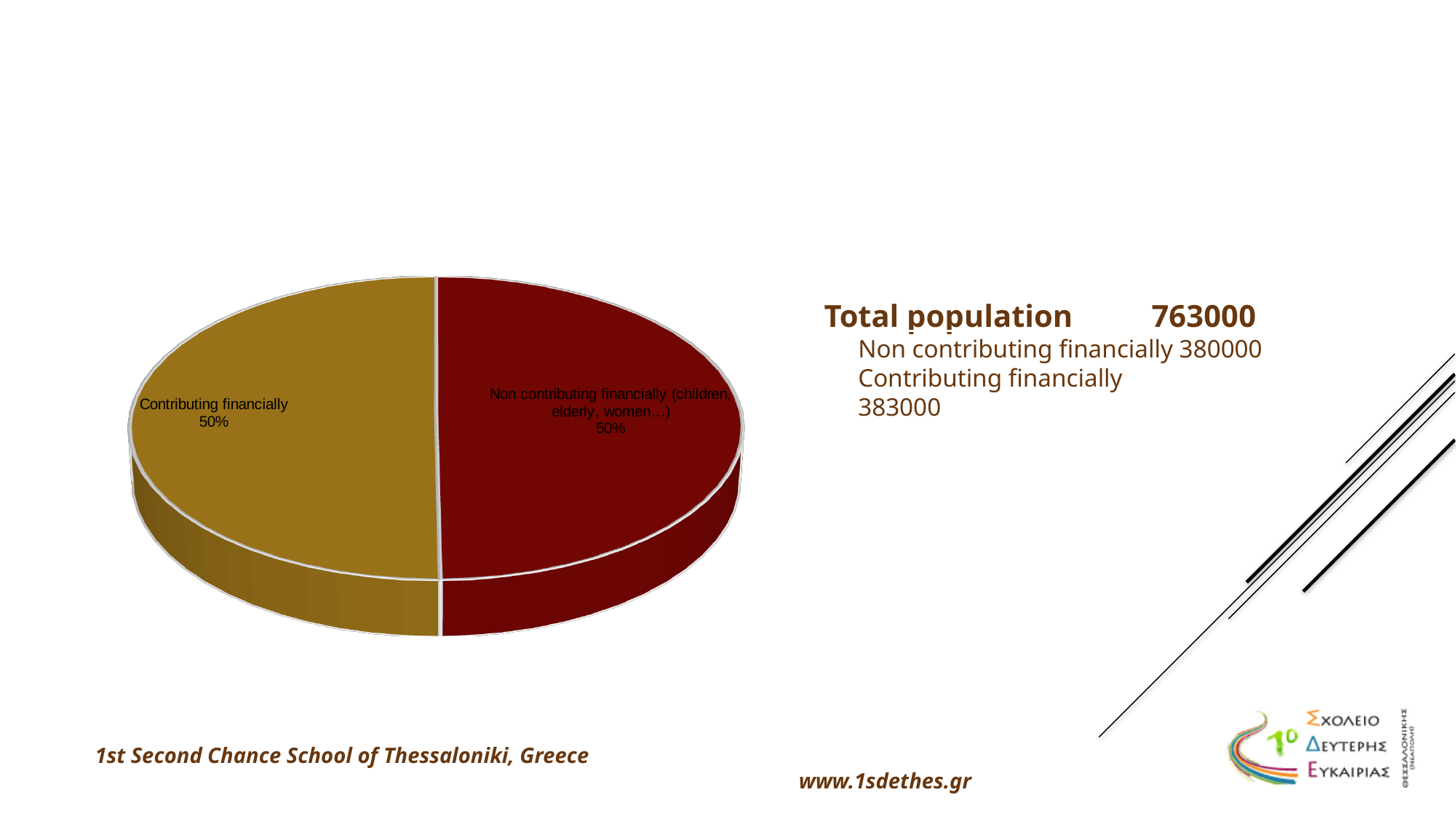
What is the percentage label shown on the 'Contributing financially' slice? 50% What is the difference in percentage between the 'Contributing financially' and 'Non contributing financially' slices? 0% What colour is the 'Non contributing financially' slice? Dark red What share of the pie does the 'Non contributing financially (children, elderly, women…)' slice represent? 50% Which groups are listed in parentheses in the 'Non contributing financially' slice label? children, elderly, women… Do the two slices of the pie chart show the same percentage? Yes, both 50% How many slices does the pie chart have? 2 What kind of chart is shown on the slide? Pie chart What share of the pie does the 'Contributing financially' slice represent? 50% What colour is the 'Contributing financially' slice? Gold/brown What is the percentage label shown on the 'Non contributing financially' slice? 50%